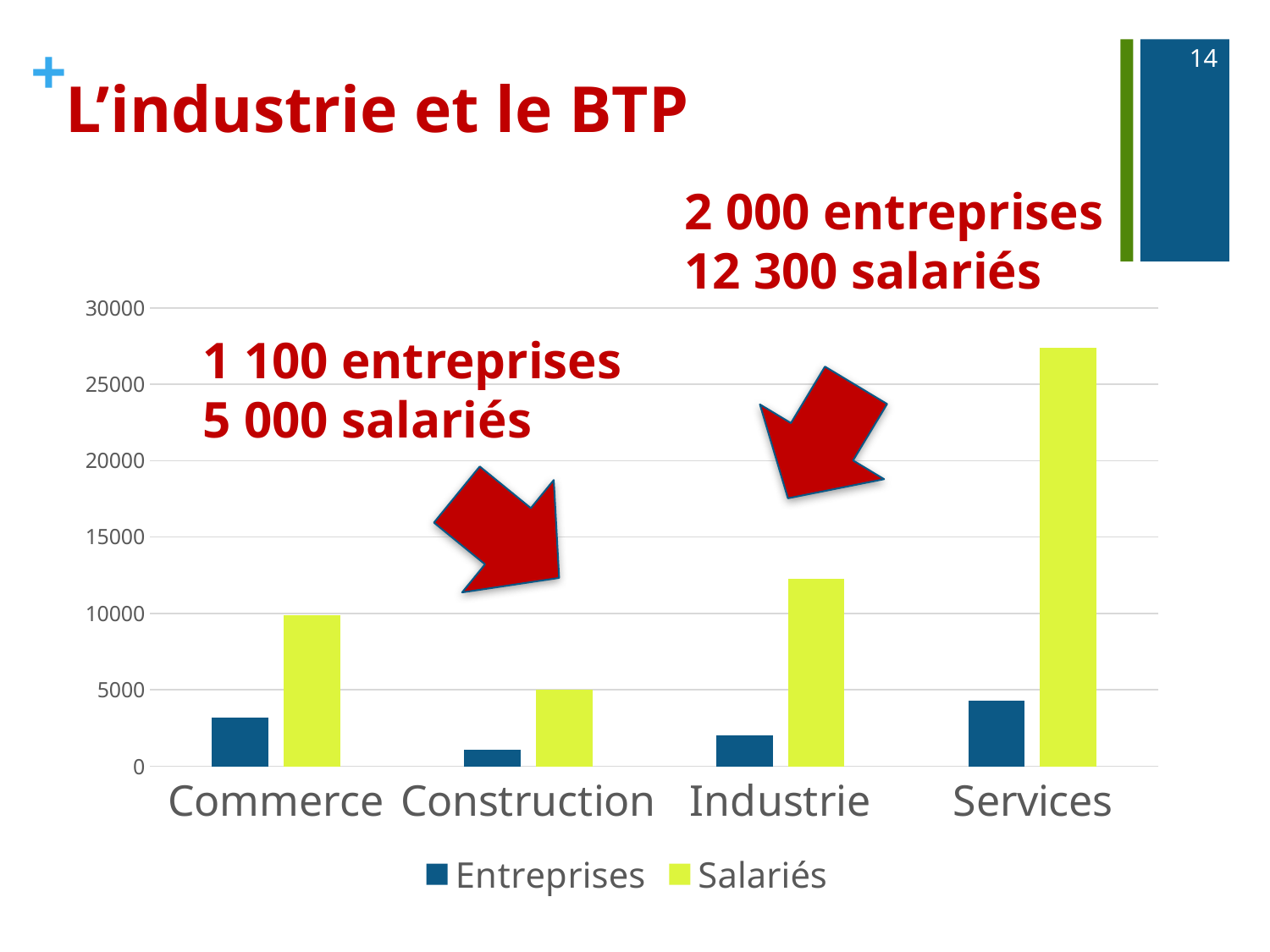
Is the Salariés value for Services greater or less than 25000? greater According to the annotation on the slide, how many salariés does the Industrie category have? 12 300 Which category has the highest Salariés value? Services Which category has the lowest Salariés value? Construction What are the two series named in the chart legend? Entreprises and Salariés Which category has the lowest Entreprises value? Construction How many series does the chart legend list? 2 According to the annotation on the slide, how many entreprises does the Construction category have? 1 100 Which is larger, the Entreprises value for Commerce or for Industrie? Commerce How many categories are shown on the x axis of the chart? 4 Is the Entreprises value for Commerce greater or less than 5000? less What kind of chart is shown on the slide? bar chart